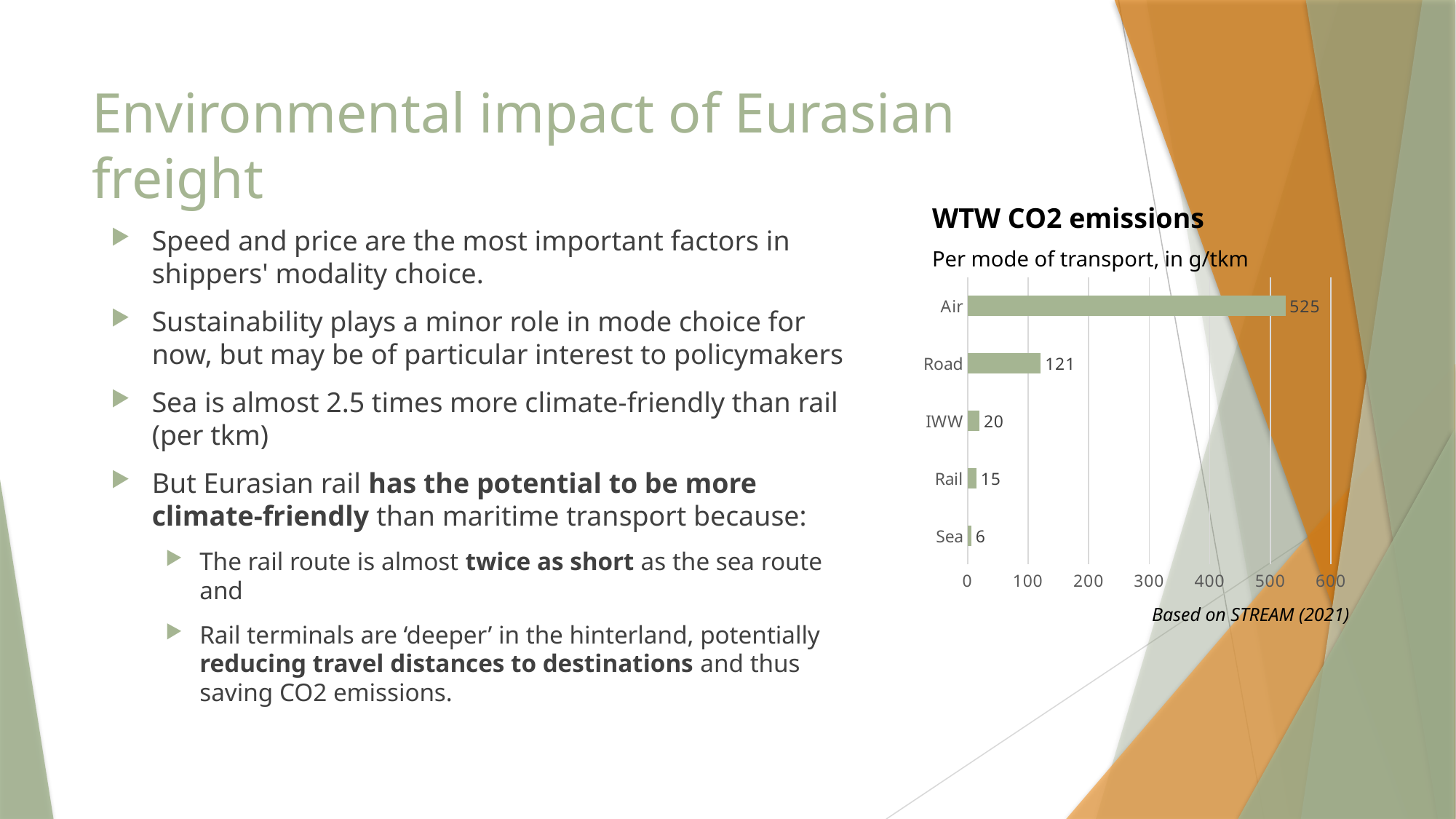
What is the WTW CO2 emissions value for IWW? 20 Which mode of transport has the highest WTW CO2 emissions? Air What is the WTW CO2 emissions value for Road? 121 What is the WTW CO2 emissions value for Air? 525 What is the WTW CO2 emissions value for Rail? 15 Which has higher WTW CO2 emissions, IWW or Rail? IWW Which mode of transport has the lowest WTW CO2 emissions? Sea What kind of chart is used to show WTW CO2 emissions? Bar chart What is the difference in WTW CO2 emissions between Rail and Sea? 9 What unit are the WTW CO2 emissions expressed in, according to the chart subtitle? g/tkm What is the difference in WTW CO2 emissions between Air and Road? 404 How many modes of transport are shown in the chart? 5